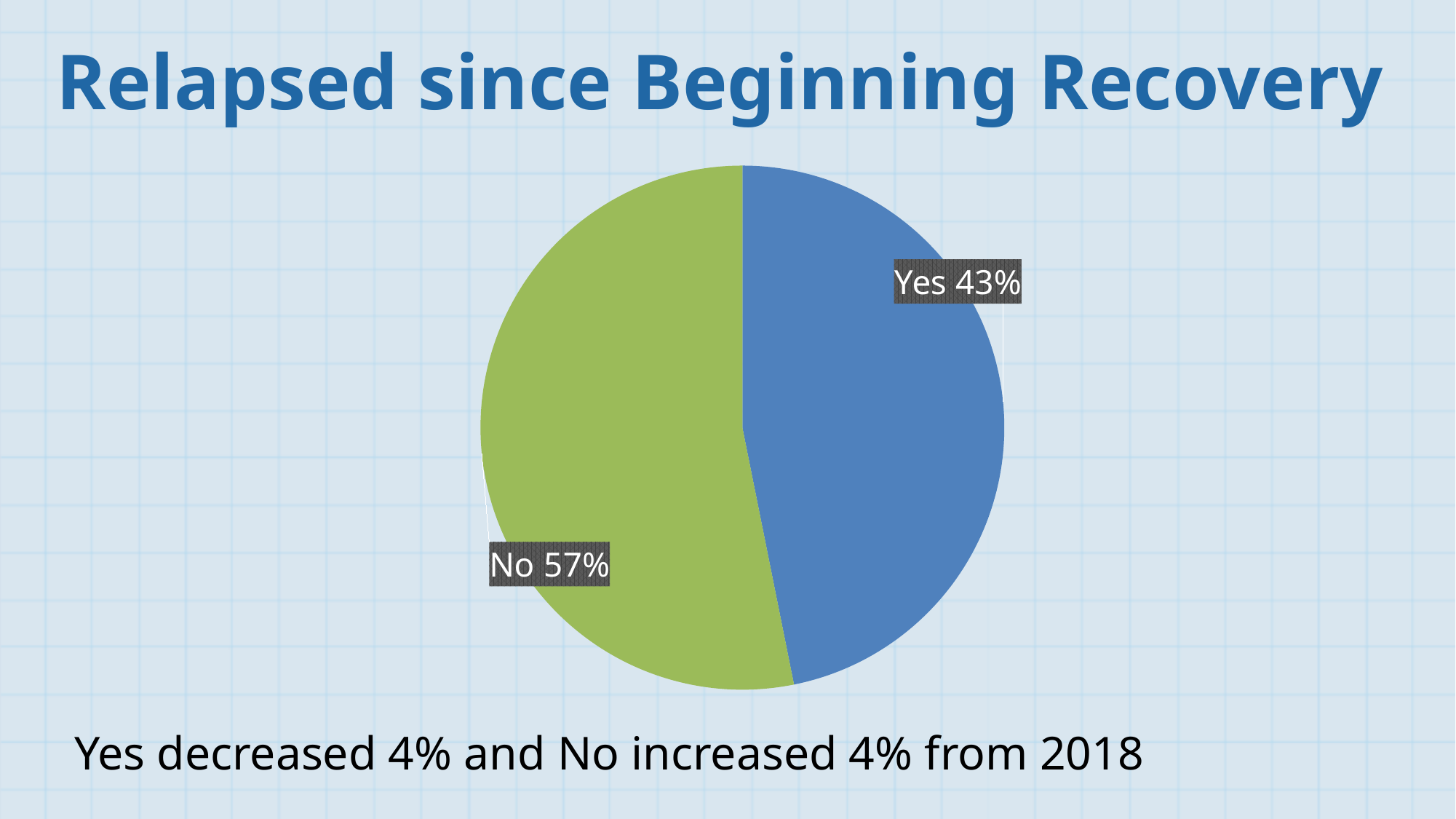
Which category has the smallest share of the pie? Yes What is the title of the chart? Relapsed since Beginning Recovery What type of chart is shown on the slide? pie chart What colour is the No slice? green What percentage of respondents answered Yes? 43% What is the combined share of the Yes and No slices? 100% What percentage of respondents answered No? 57% How many slices does the pie chart have? 2 Which category has the largest share of the pie? No Which is larger, the Yes slice or the No slice? No What is the difference in percentage points between No and Yes? 14